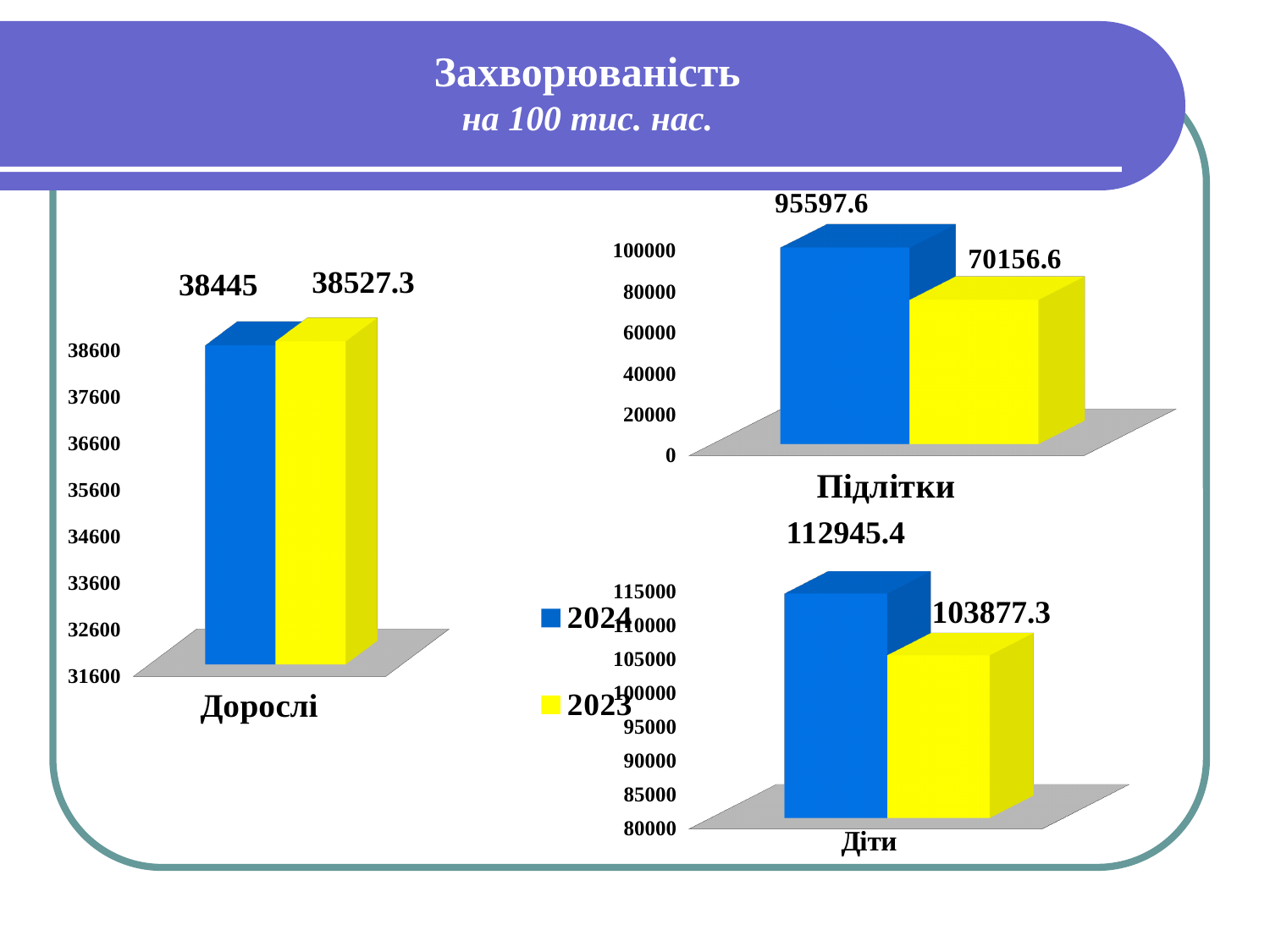
In the chart titled Дорослі, what is the value for 2024? 38445 In the chart titled Діти, what is the value for 2024? 112945.4 In the chart titled Діти, what is the difference between the 2024 and 2023 values? 9068.1 In the chart titled Підлітки, which year has the larger value, 2024 or 2023? 2024 In the chart titled Діти, what is the value for 2023? 103877.3 In the chart titled Підлітки, what is the difference between the 2024 and 2023 values? 25441 In the chart titled Дорослі, which year has the larger value, 2024 or 2023? 2023 What kind of chart is the chart titled Діти? Bar chart In the chart titled Підлітки, what is the value for 2023? 70156.6 In the chart titled Підлітки, what is the value for 2024? 95597.6 In the chart titled Дорослі, what is the value for 2023? 38527.3 How many series does the legend on the slide list? 2